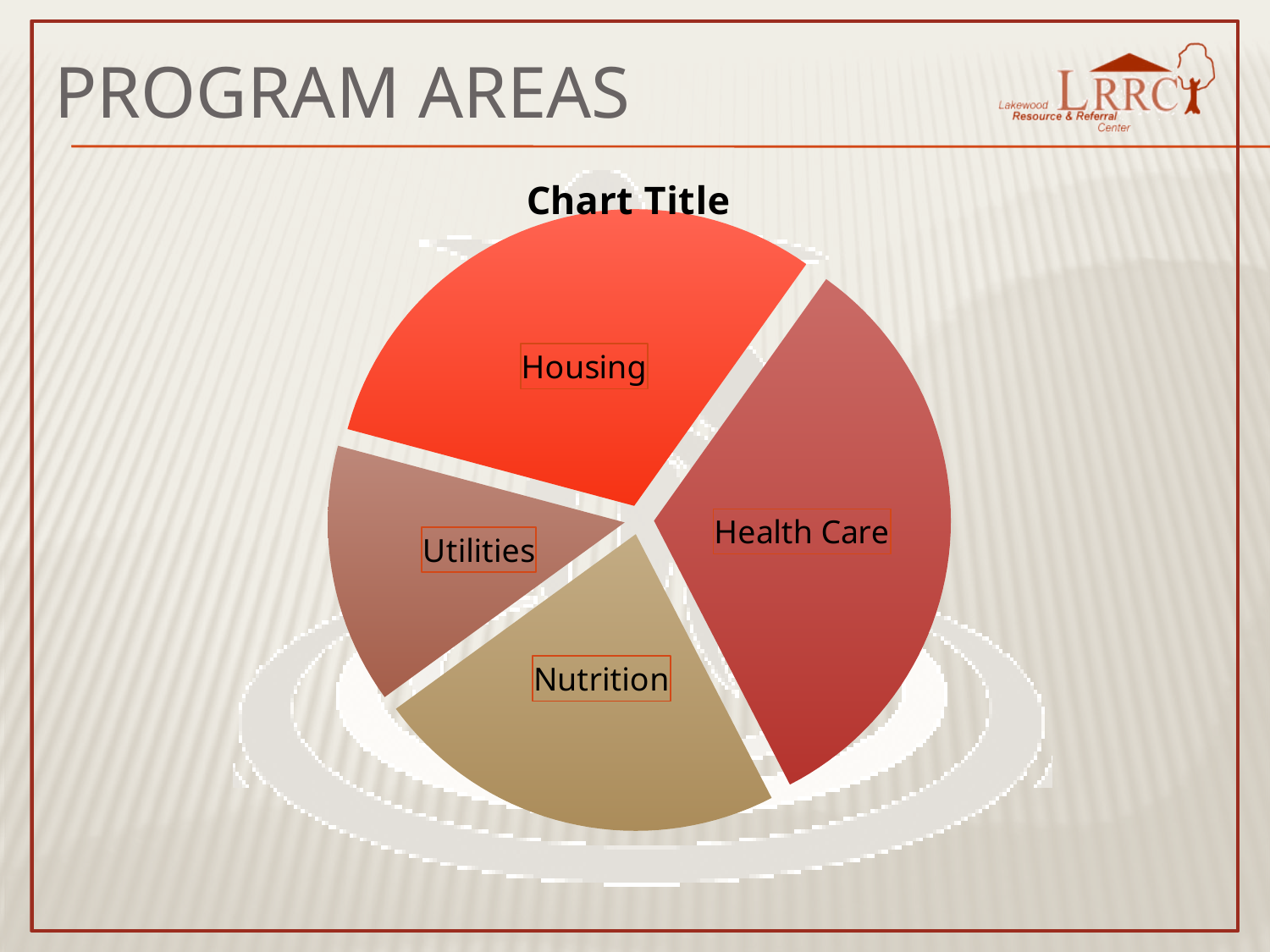
What kind of chart is shown on the slide? pie chart How many slices does the pie chart have? 4 Which slice of the pie chart is larger, Housing or Utilities? Housing Which slice of the pie chart is larger, Health Care or Utilities? Health Care Which slice of the pie chart is larger, Housing or Nutrition? Housing Which slice of the pie chart is coloured tan/beige? Nutrition What is the title shown above the pie chart? Chart Title